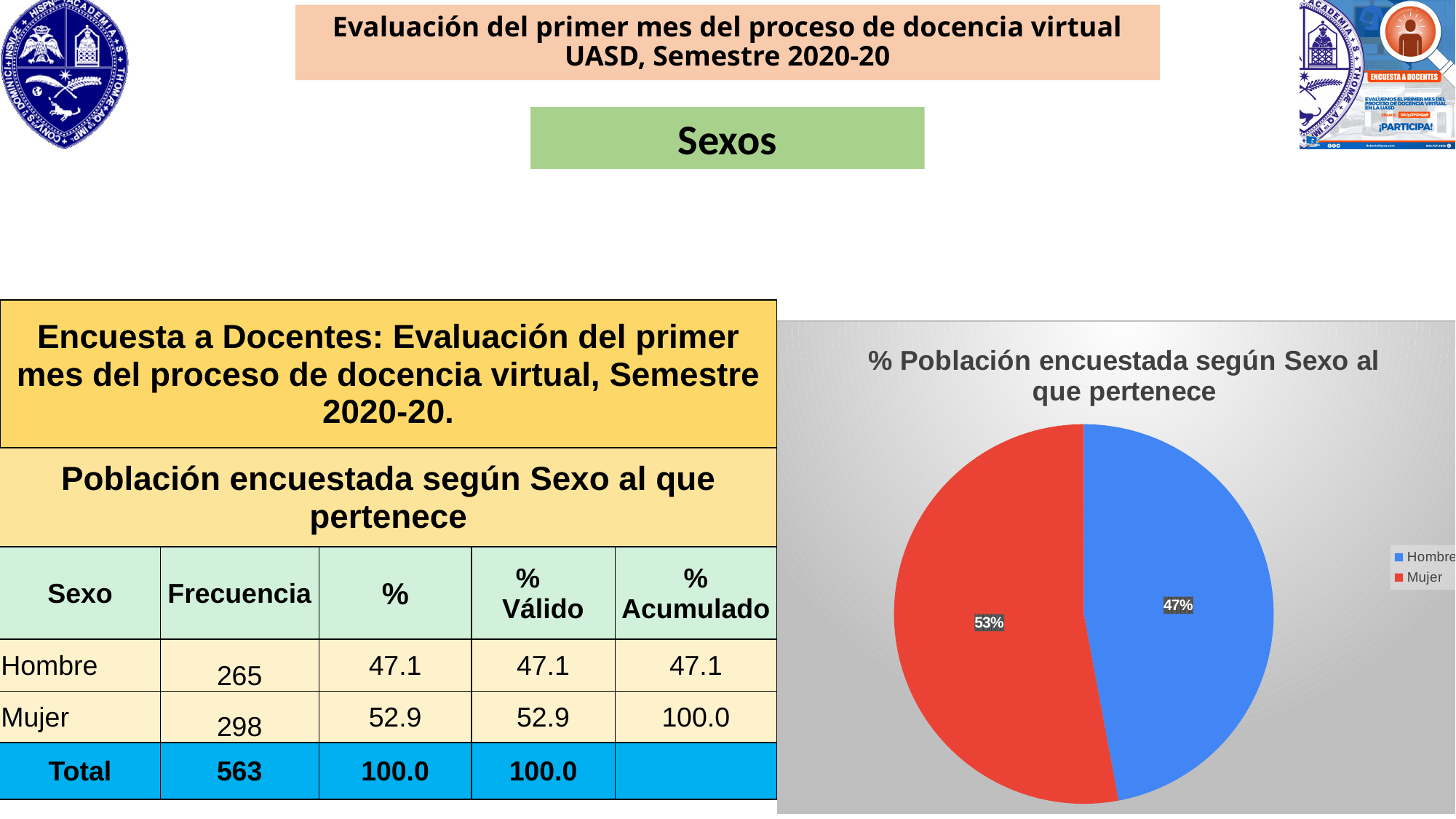
Which slice of the pie chart is the smallest? Hombre How many series does the legend of the pie chart list? 2 What kind of chart is shown on the slide? pie chart What share of the pie does Mujer represent? 53% How many slices does the pie chart have? 2 What is the value shown for the Mujer slice in the pie chart? 53% What is the difference between the Mujer and Hombre shares in the pie chart? 6% Which slice of the pie chart is the largest? Mujer What is the title of the pie chart? % Población encuestada según Sexo al que pertenece What is the value shown for the Hombre slice in the pie chart? 47% What share of the pie does Hombre represent? 47% Which is larger in the pie chart, Hombre or Mujer? Mujer